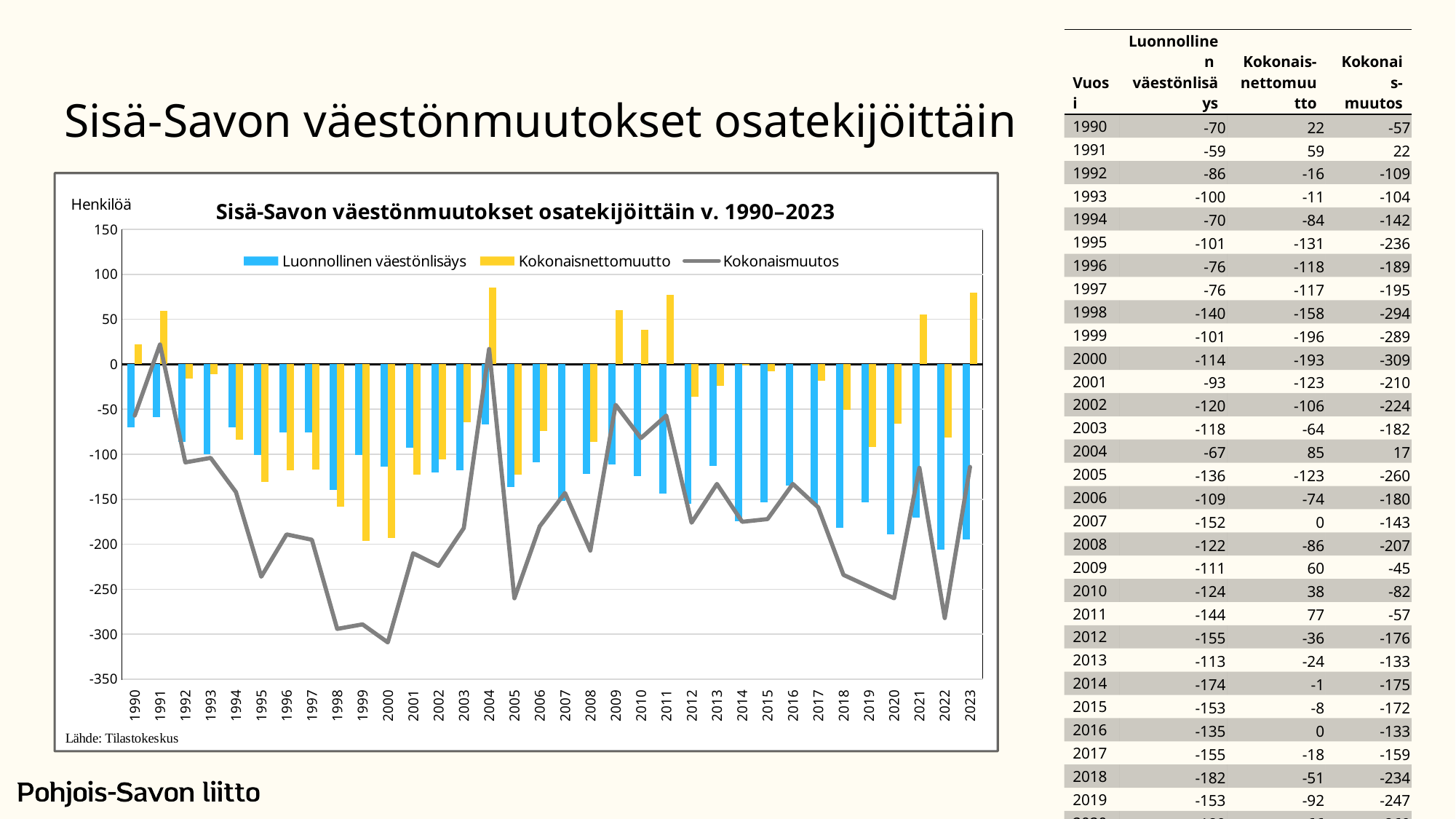
What is the Kokonaisnettomuutto value for 2007? 0 Does the Kokonaismuutos line rise or fall from 1991 to 2000? It falls Is the Kokonaismuutos value for 2022 greater or less than -250? less What kind of chart is shown on the slide? A bar chart combined with a line What is the Kokonaismuutos value for the year 2000? -309 What is the difference between the Kokonaismuutos values for 1994 and 1995? 94 Which year has the larger Luonnollinen väestönlisäys value, 2018 or 2019? 2019 What is the Kokonaisnettomuutto value for 2011? 77 Is the Luonnollinen väestönlisäys value for 2023 greater or less than -150? less How many years are plotted along the x axis of the chart? 34 Which year has the lowest Kokonaismuutos value in the chart? 2000 How many series does the chart legend list? 3